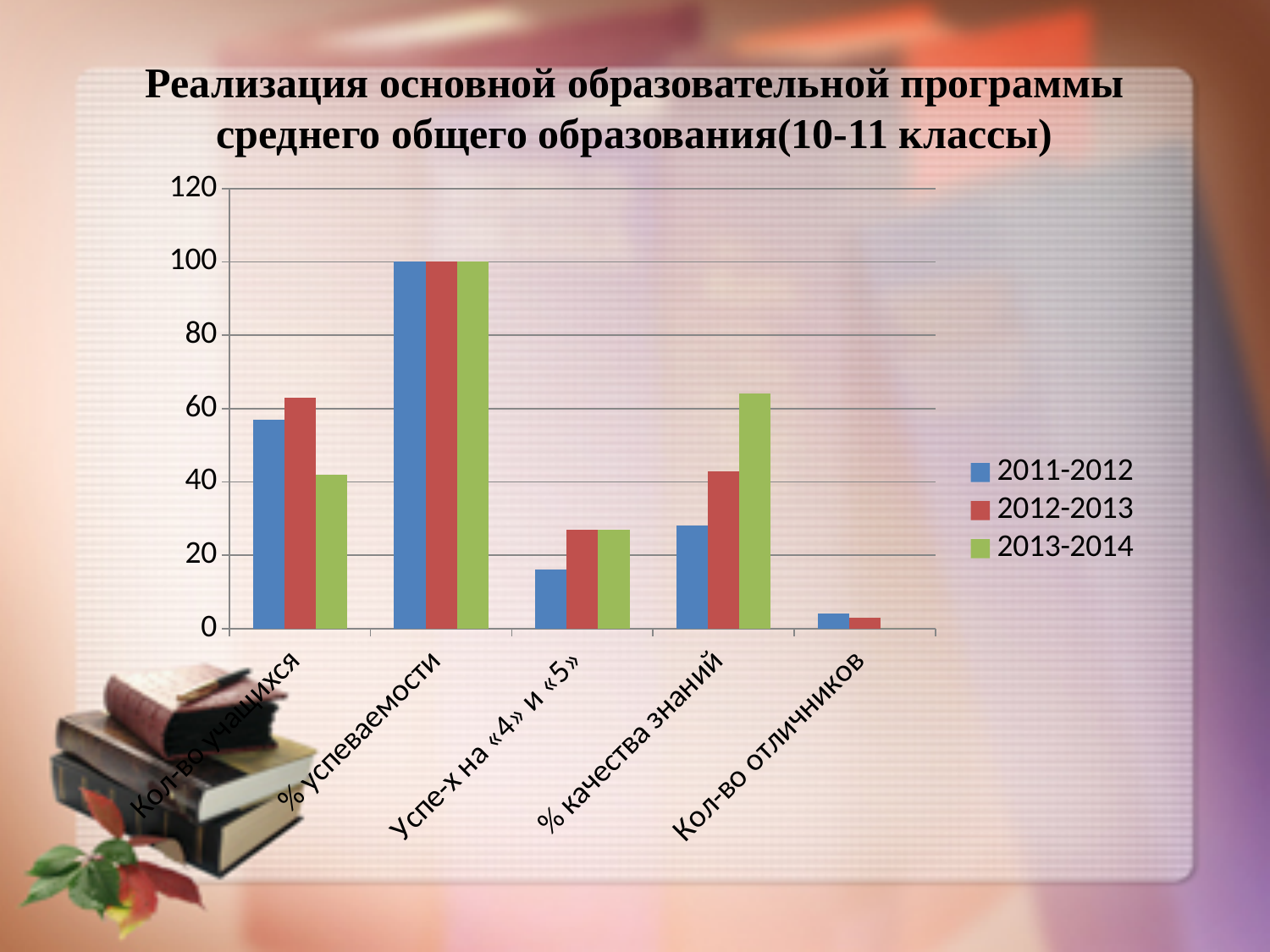
Is the value for Кол-во учащихся in 2012-2013 greater or less than 60? greater Which series has the highest value for % качества знаний? 2013-2014 Is the value for Кол-во учащихся in 2013-2014 greater or less than 60? less Which is larger for Кол-во учащихся: the 2011-2012 value or the 2012-2013 value? 2012-2013 Is the value for % качества знаний in 2013-2014 greater or less than 60? greater What is the value for % успеваемости in 2011-2012? 100 How many categories are shown on the x axis? 5 What is the value for % успеваемости in 2013-2014? 100 How many series does the legend list? 3 Which series has the lowest value for Кол-во учащихся? 2013-2014 What kind of chart is shown on the slide? bar chart